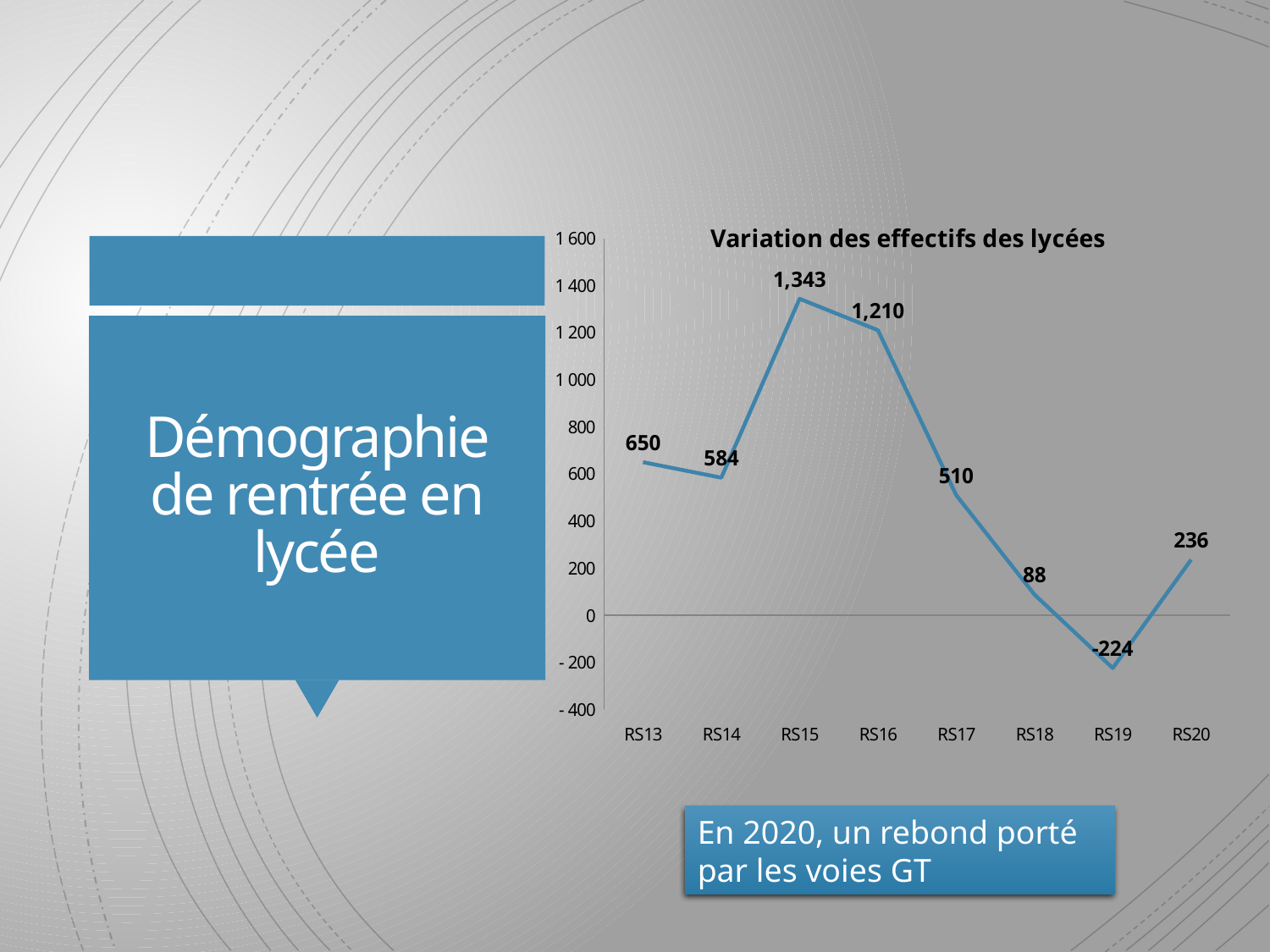
What is the difference between the values for RS15 and RS16? 133 How many categories are shown on the x axis? 8 What is the value for RS19? -224 What is the difference between the values for RS13 and RS14? 66 What kind of chart is shown? line chart Which category has the lowest value? RS19 What is the value for RS15? 1,343 Which category has the highest value? RS15 Which is larger, the value for RS17 or the value for RS18? RS17 Is the value for RS16 greater or less than 1 000? greater What is the value for RS20? 236 What is the title of the chart? Variation des effectifs des lycées